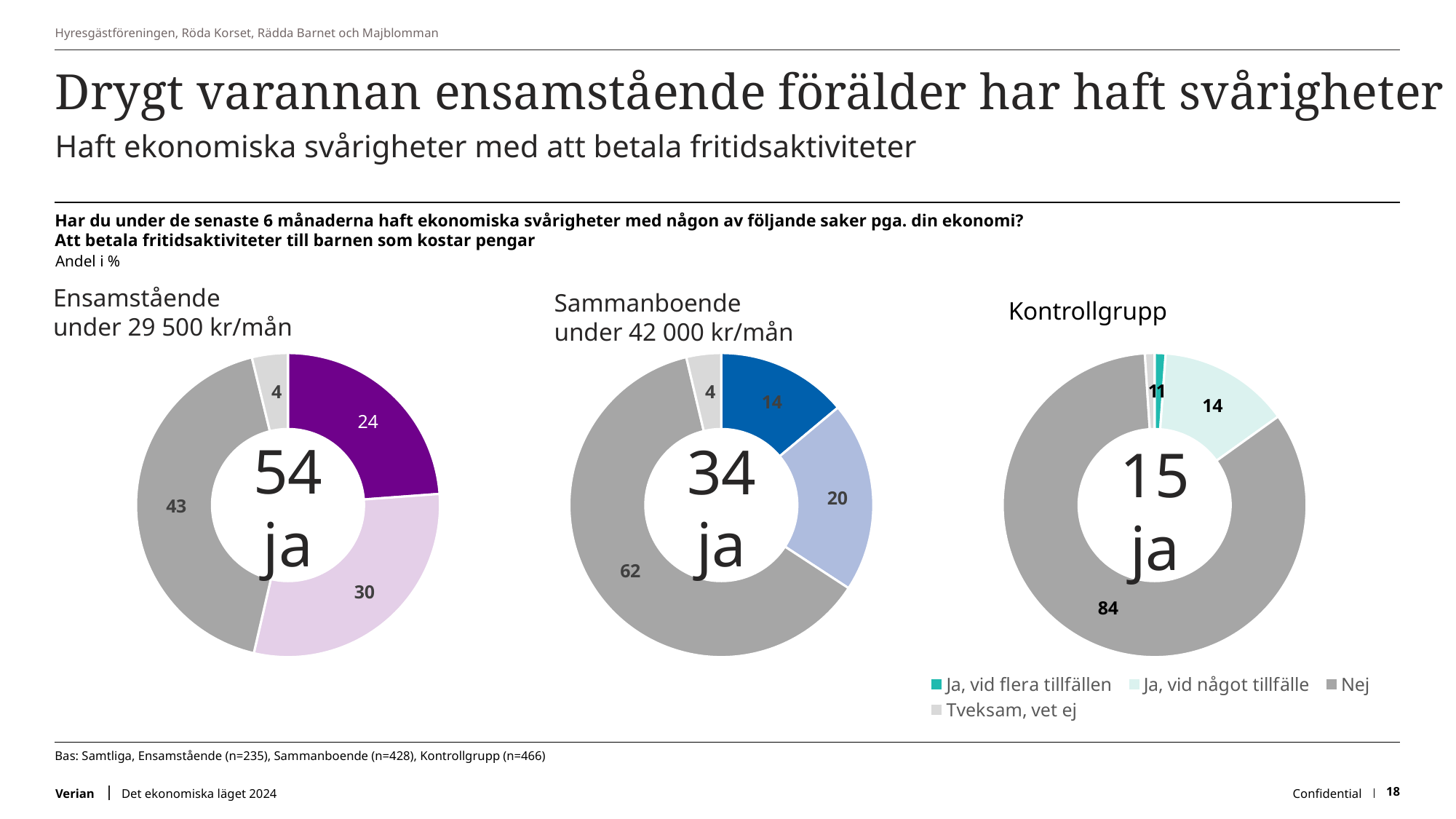
In the Ensamstående under 29 500 kr/mån chart, what is the value for Ja, vid flera tillfällen? 24 In the Sammanboende under 42 000 kr/mån chart, which is larger: Ja, vid flera tillfällen or Ja, vid något tillfälle? Ja, vid något tillfälle How many series does the legend list? 4 In the Ensamstående under 29 500 kr/mån chart, which category has the smallest share? Tveksam, vet ej In the Sammanboende under 42 000 kr/mån chart, which category has the largest share? Nej In the Sammanboende under 42 000 kr/mån chart, what is the value for Ja, vid något tillfälle? 20 What kind of chart is used for the Kontrollgrupp data? Donut (pie) chart In the Ensamstående under 29 500 kr/mån chart, what is the difference between Nej and Ja, vid något tillfälle? 13 What total 'ja' share is shown in the centre of the Sammanboende under 42 000 kr/mån chart? 34 In the Ensamstående under 29 500 kr/mån chart, what is the value for Nej? 43 What total 'ja' share is shown in the centre of the Kontrollgrupp chart? 15 In the Kontrollgrupp chart, what is the value for Nej? 84